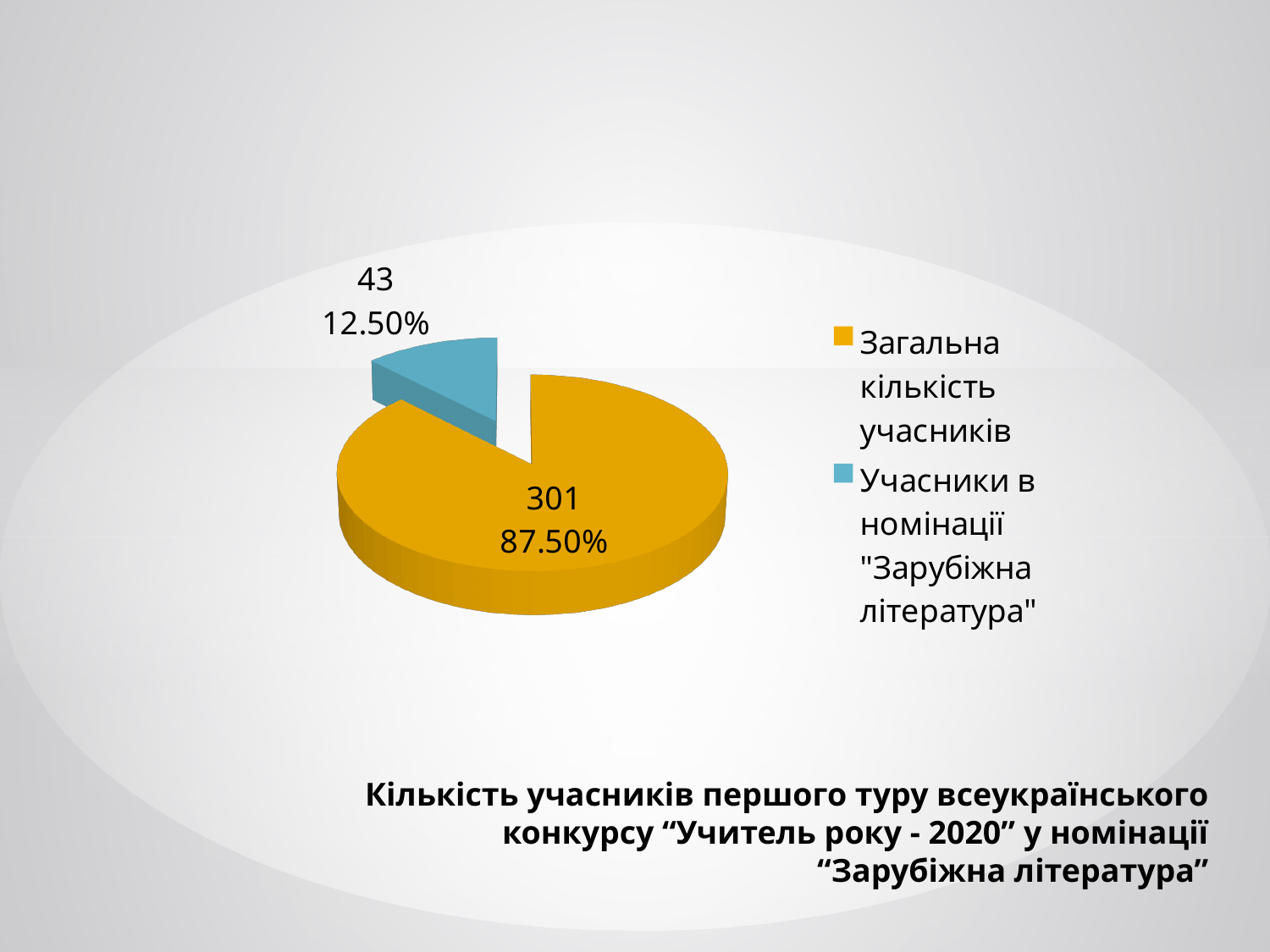
What value is shown for the slice "Загальна кількість учасників"? 301 What percentage share does the slice "Учасники в номінації "Зарубіжна література"" have? 12.50% How many entries does the legend list? 2 Which is larger: the value for "Загальна кількість учасників" or the value for "Учасники в номінації "Зарубіжна література""? Загальна кількість учасників What is the difference between the values 301 and 43 shown on the pie chart? 258 What percentage share does the slice "Загальна кількість учасників" have? 87.50% Which slice of the pie is the largest? Загальна кількість учасників What value is shown for the slice "Учасники в номінації "Зарубіжна література""? 43 What colour is the slice for "Учасники в номінації "Зарубіжна література""? Blue Which slice of the pie is the smallest? Учасники в номінації "Зарубіжна література" How many slices does the pie chart have? 2 What type of chart is shown on the slide? Pie chart